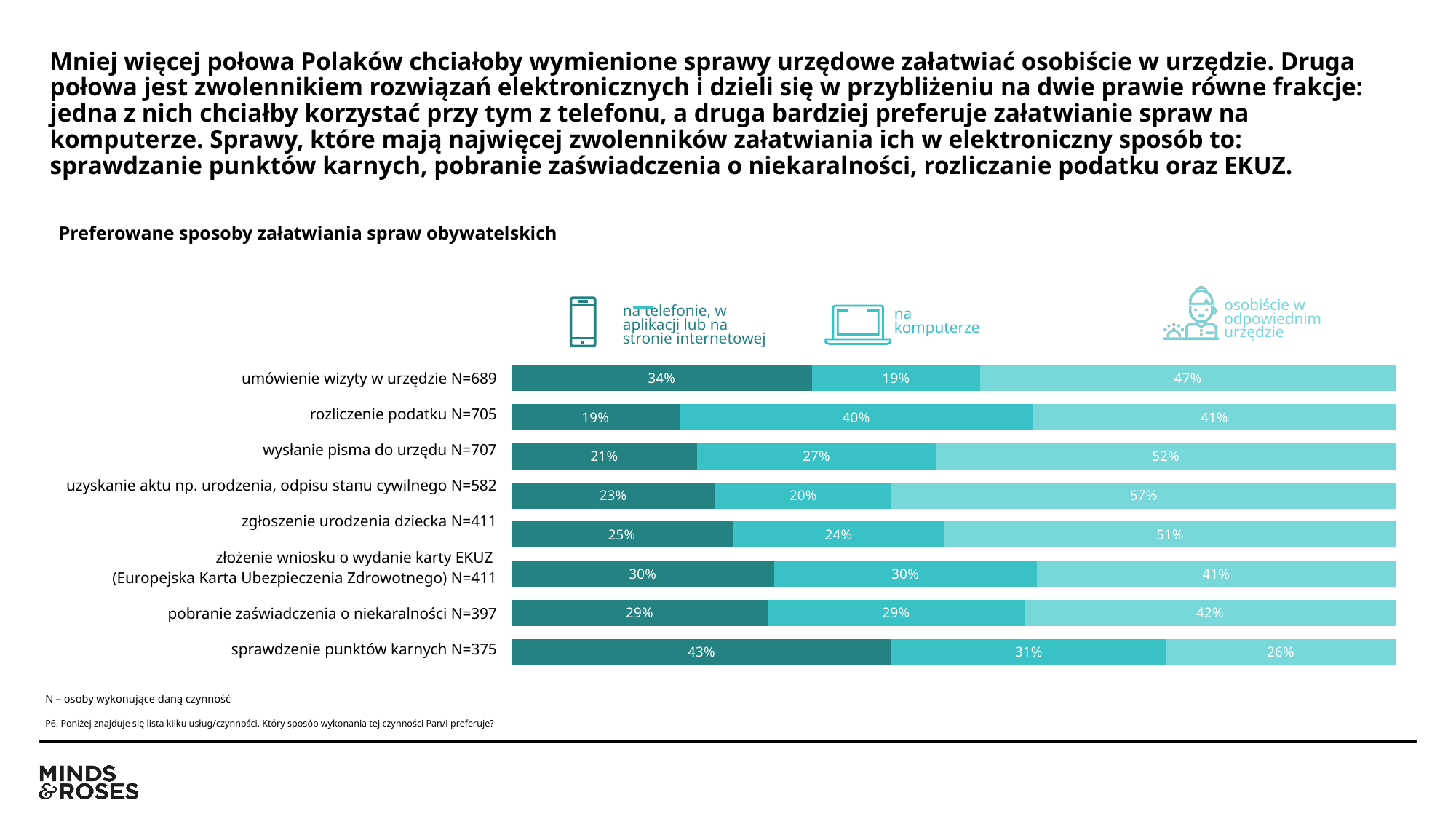
What is the difference between the in-person share for 'wysłanie pisma do urzędu' and the in-person share for 'sprawdzenie punktów karnych'? 26 percentage points What percentage prefer to handle 'umówienie wizyty w urzędzie' on a phone, app or website ('na telefonie, w aplikacji lub na stronie internetowej')? 34% Which is larger: the computer share for 'rozliczenie podatku' or the computer share for 'umówienie wizyty w urzędzie'? rozliczenie podatku How many activities (categories) are shown in the chart? 8 What percentage prefer to handle 'sprawdzenie punktów karnych' in person ('osobiście w odpowiednim urzędzie')? 26% What type of chart is shown on the slide? Stacked bar chart What is the total of the three segments for 'zgłoszenie urodzenia dziecka'? 100% How many series (ways of handling matters) does the legend list? 3 Which activity has the lowest share of respondents preferring the phone/app/website option? rozliczenie podatku What is the title of the chart? Preferowane sposoby załatwiania spraw obywatelskich What percentage of respondents prefer to handle 'rozliczenie podatku' on a computer ('na komputerze')? 40% Which activity has the highest share of respondents preferring to handle it in person ('osobiście w odpowiednim urzędzie')? uzyskanie aktu np. urodzenia, odpisu stanu cywilnego